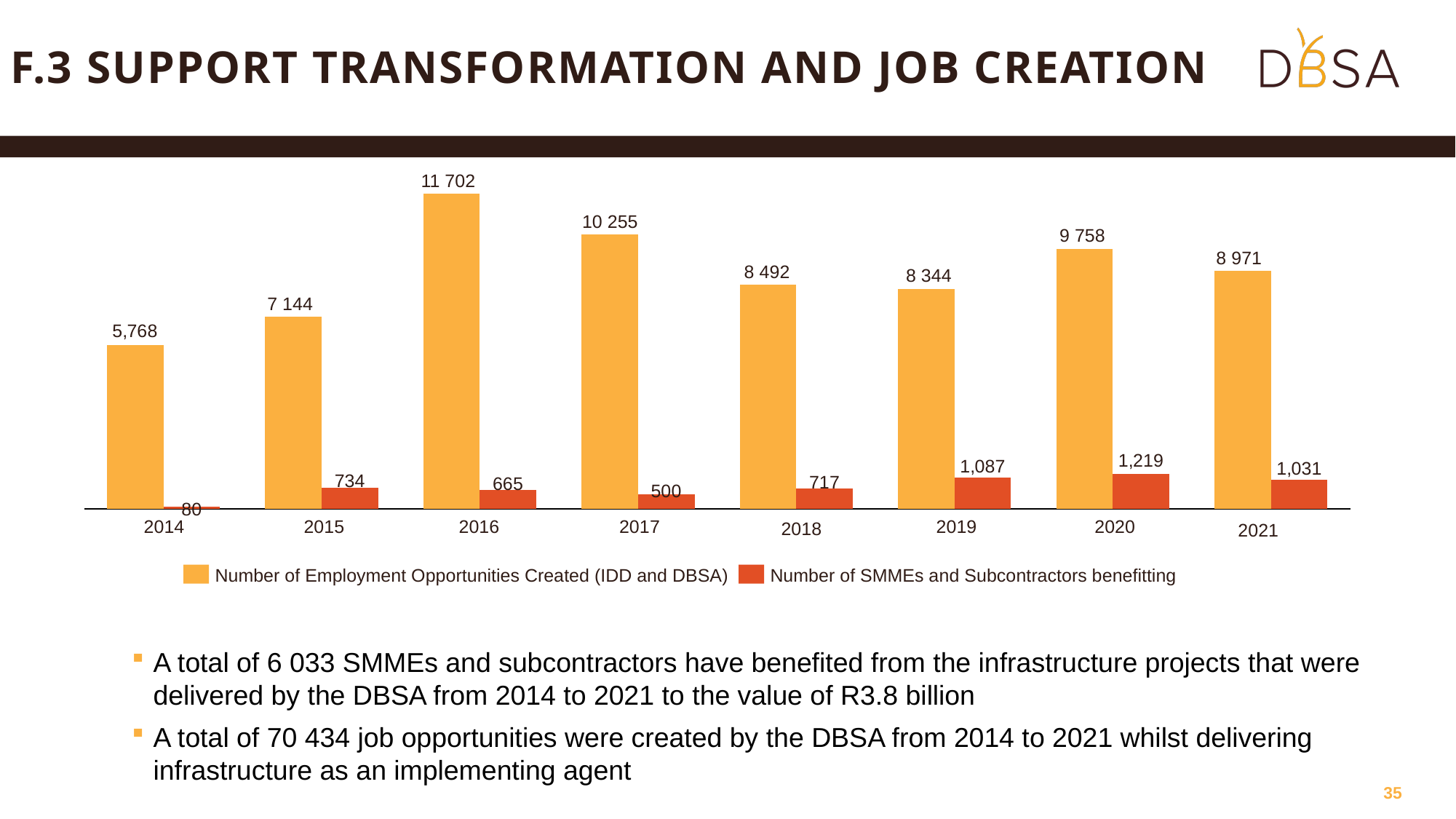
What is the difference between the Number of SMMEs and Subcontractors benefitting in 2015 and in 2016? 69 Which year had more Employment Opportunities Created, 2018 or 2019? 2018 What is the Number of Employment Opportunities Created (IDD and DBSA) in 2016? 11 702 How many series does the chart's legend list? 2 What is the Number of SMMEs and Subcontractors benefitting in 2017? 500 In which year was the Number of SMMEs and Subcontractors benefitting lowest? 2014 How many years are shown on the x axis of the chart? 8 In which year was the Number of SMMEs and Subcontractors benefitting highest? 2020 What is the Number of Employment Opportunities Created (IDD and DBSA) in 2014? 5,768 What is the Number of SMMEs and Subcontractors benefitting in 2020? 1,219 In which year was the Number of Employment Opportunities Created (IDD and DBSA) highest? 2016 What is the difference between the Number of Employment Opportunities Created in 2016 and in 2017? 1 447